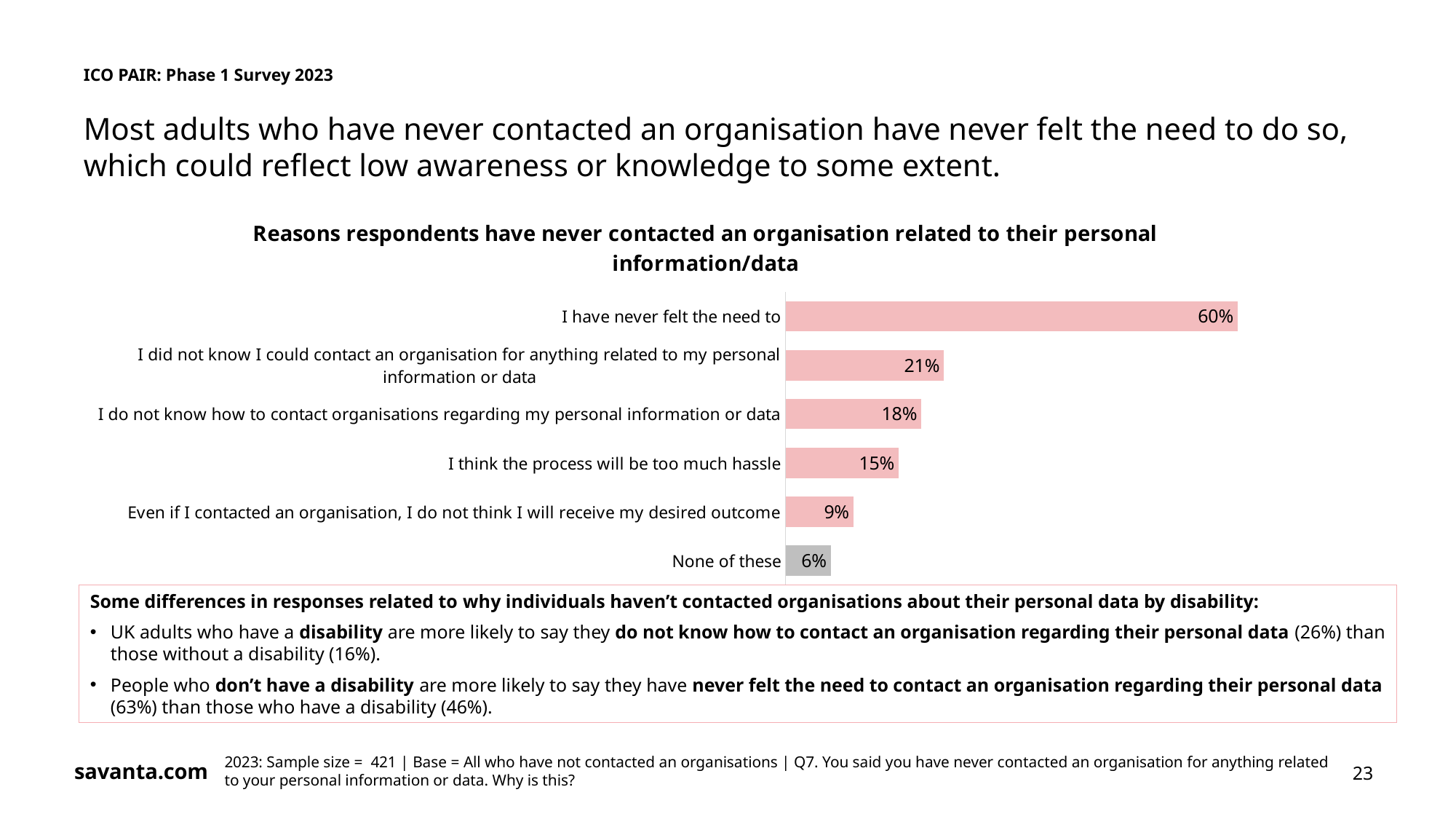
Which reason has the highest percentage of respondents? I have never felt the need to What is the difference in percentage points between "I have never felt the need to" and "I did not know I could contact an organisation for anything related to my personal information or data"? 39 percentage points What percentage of respondents said "I think the process will be too much hassle"? 15% Which category has the lowest percentage of respondents? None of these How many categories (bars) are shown in the chart? 6 What percentage of respondents said "I have never felt the need to"? 60% What is the title of the chart? Reasons respondents have never contacted an organisation related to their personal information/data What percentage of respondents said "I do not know how to contact organisations regarding my personal information or data"? 18% What percentage of respondents selected "None of these"? 6% Which bar in the chart is coloured grey rather than pink? None of these What type of chart is shown on the slide? Bar chart Which is larger: the percentage for "I think the process will be too much hassle" or for "Even if I contacted an organisation, I do not think I will receive my desired outcome"? I think the process will be too much hassle